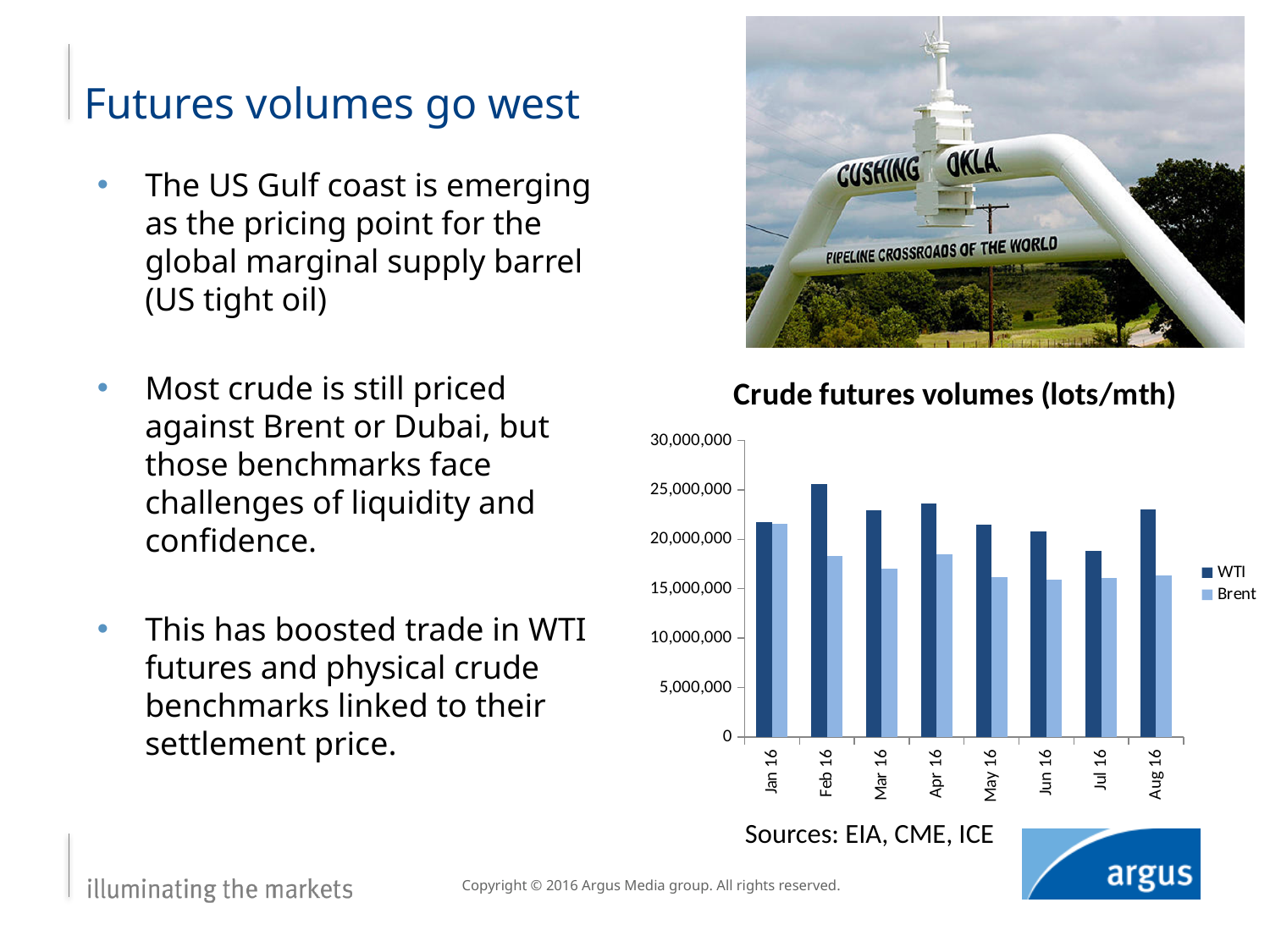
In which month is the WTI futures volume lowest? Jul 16 What is the title of the chart? Crude futures volumes (lots/mth) Do Brent futures volumes generally rise or fall from Jan 16 to Aug 16? fall How many months are shown on the x axis of the chart? 8 Is the WTI value for Feb 16 greater or less than 25,000,000? greater Which is larger in Aug 16, the WTI volume or the Brent volume? WTI In which month is the Brent futures volume highest? Jan 16 How many series does the legend of the chart list? 2 In which month is the WTI futures volume highest? Feb 16 What kind of chart is shown on the slide? bar chart Which series is shown in the darker blue colour in the chart? WTI Is the Brent value for Jun 16 greater or less than 20,000,000? less